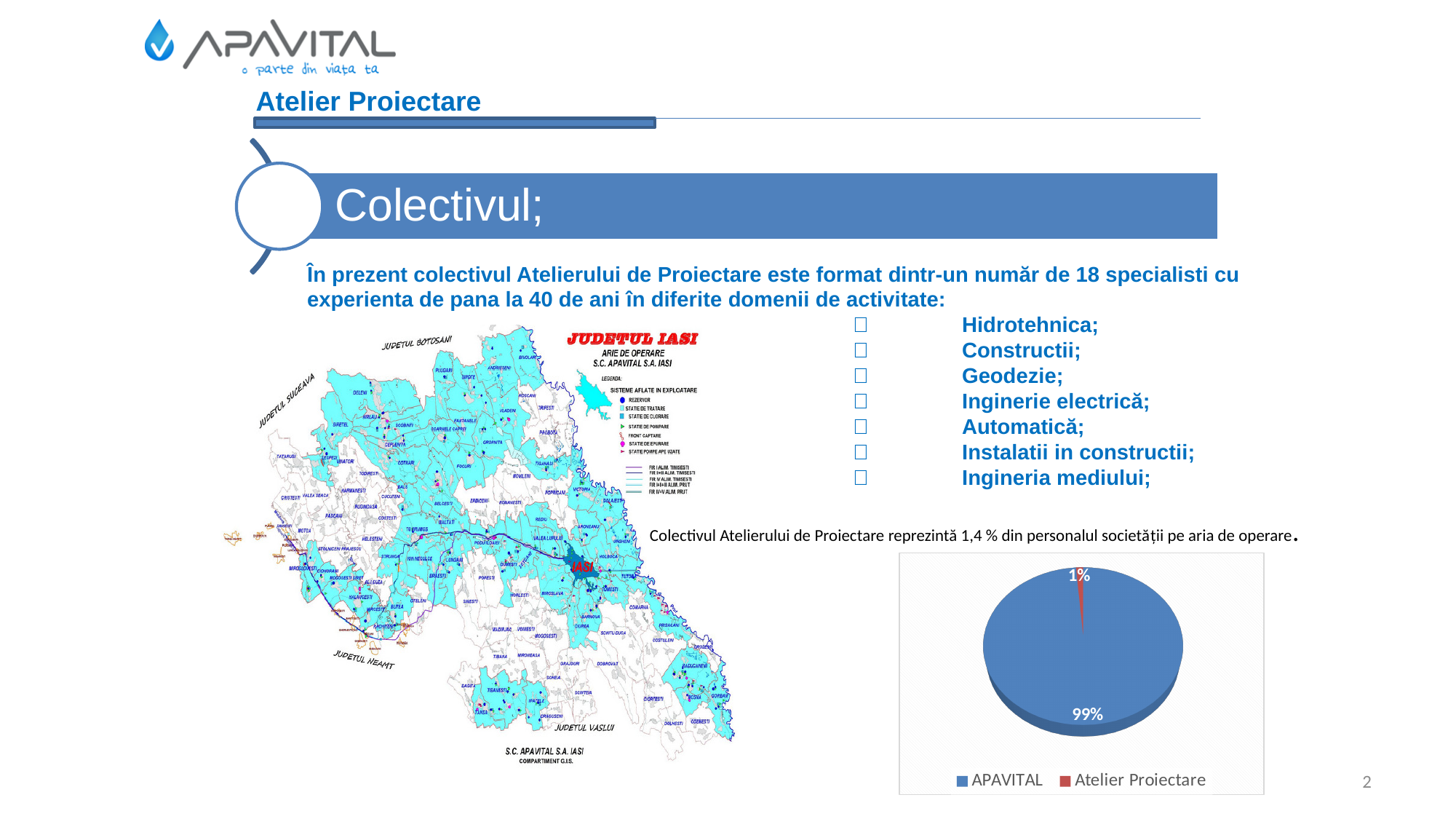
Which slice of the pie chart is the smallest? Atelier Proiectare What is the difference in percentage points between the APAVITAL slice and the Atelier Proiectare slice? 98 In the pie chart, what share is labelled for APAVITAL? 99% Which is larger in the pie chart, the APAVITAL slice or the Atelier Proiectare slice? APAVITAL What kind of chart is shown at the bottom right of the slide? pie chart In the pie chart, what share is labelled for Atelier Proiectare? 1% How many entries does the pie chart's legend list? 2 Which slice of the pie chart is the largest? APAVITAL What colour is the APAVITAL slice in the pie chart? blue How many slices does the pie chart have? 2 What colour is the Atelier Proiectare slice in the pie chart? red